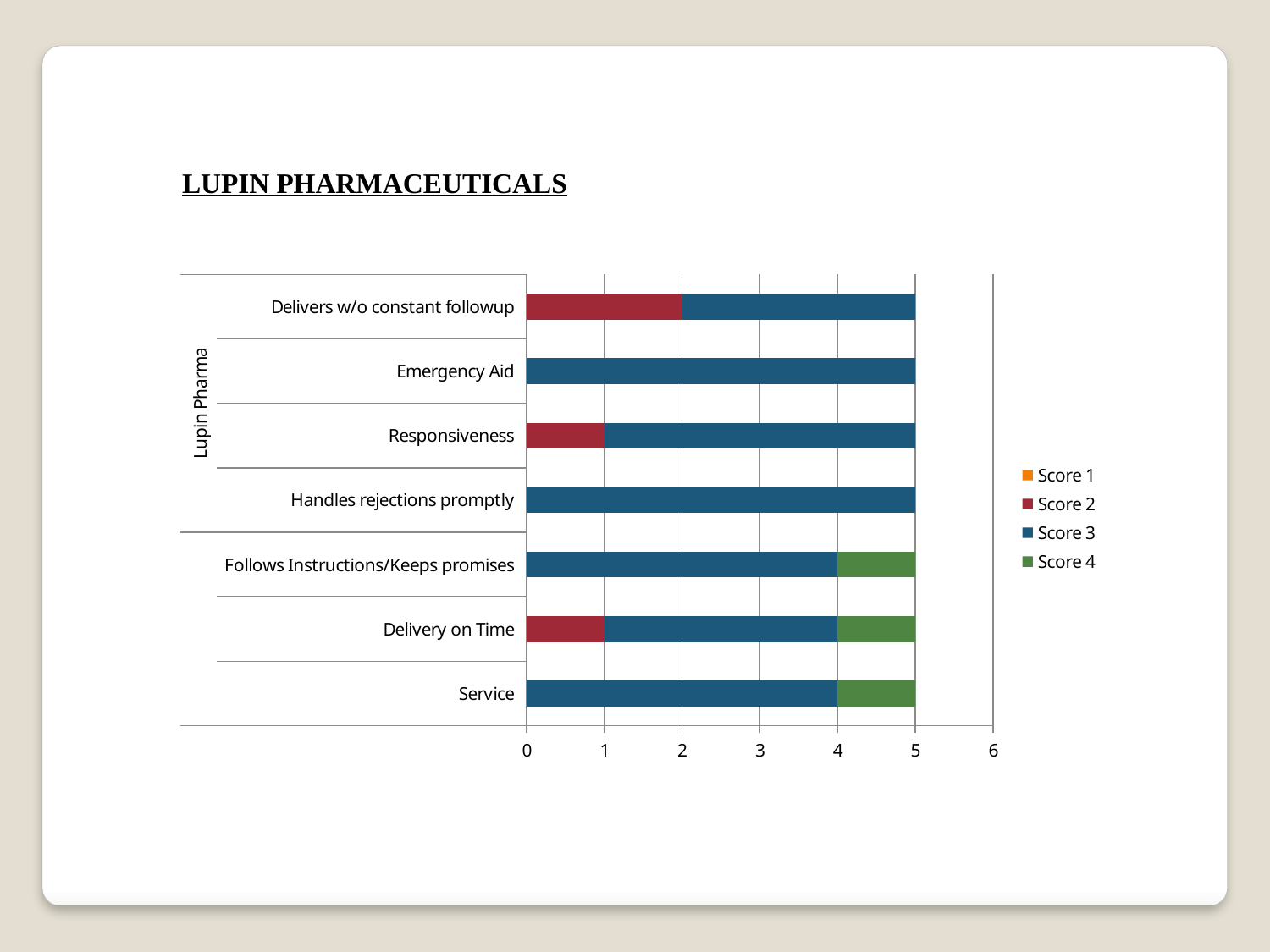
What is the Score 3 value for Emergency Aid? 5 Which category has the highest Score 2 value? Delivers w/o constant followup What is the total of the stacked bar for Delivery on Time? 5 How many series does the legend list? 4 What kind of chart is shown on the slide? Stacked bar chart What is the difference between the Score 3 value for Emergency Aid and the Score 3 value for Delivery on Time? 2 What is the Score 4 value for Service? 1 What is the Score 2 value for Delivers w/o constant followup? 2 Which is larger, the Score 2 value for Delivers w/o constant followup or the Score 2 value for Responsiveness? Delivers w/o constant followup What is the Score 3 value for Responsiveness? 4 How many categories are plotted on the chart? 7 What is the label on the vertical axis of the chart? Lupin Pharma